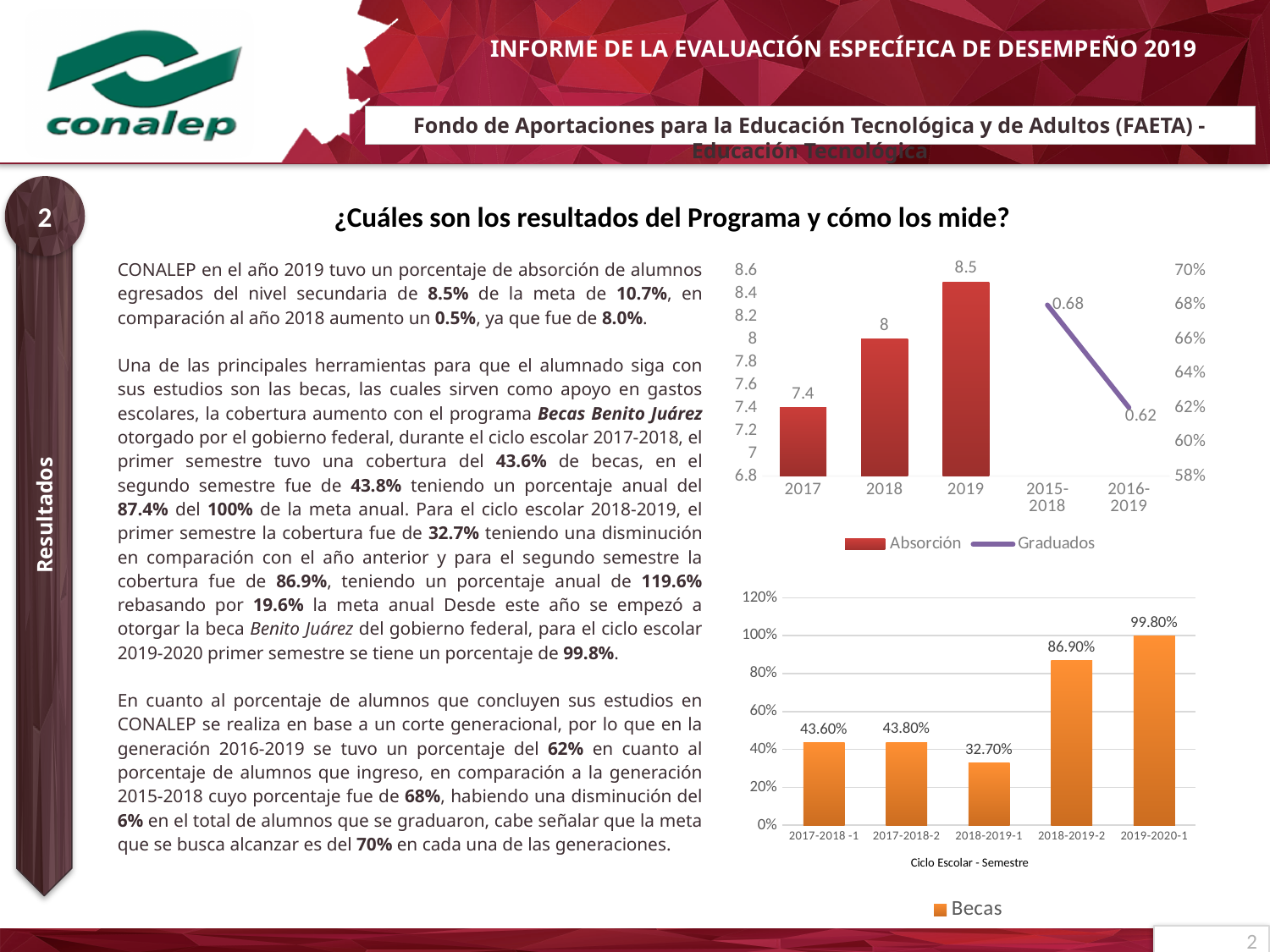
In the top chart, does the Graduados line rise or fall from 2015-2018 to 2016-2019? fall In the top chart, what is the difference between the Absorción values for 2019 and 2017? 1.1 In the top chart, which year has the highest Absorción value? 2019 In the top chart, what is the Graduados value for 2015-2018? 0.68 In the top chart, what is the Absorción value for 2017? 7.4 In the top chart, what is the Absorción value for 2019? 8.5 In the bottom chart, what is the difference between the Becas values for 2018-2019-2 and 2018-2019-1? 54.20% In the bottom chart, what is the Becas value for 2018-2019-1? 32.70% In the bottom chart, which semester has the lowest Becas value? 2018-2019-1 In the bottom chart, what is the Becas value for 2019-2020-1? 99.80% How many series does the legend of the top chart list? 2 How many categories are shown on the x axis of the bottom chart? 5